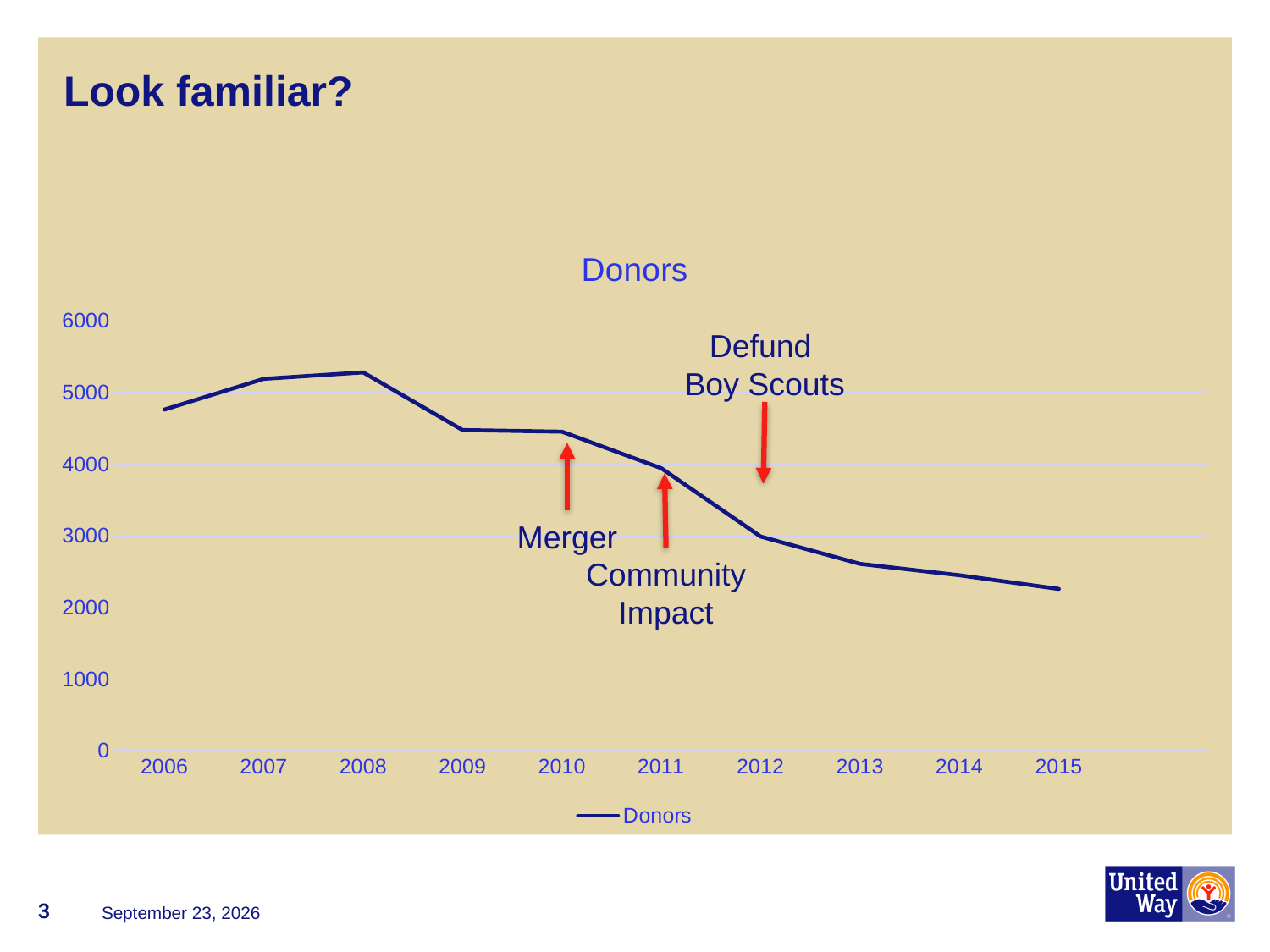
What is the title of the chart? Donors Do the donor values generally rise or fall from 2008 to 2015? fall Which year has the lowest number of donors? 2015 What kind of chart is shown on the slide? line chart How many years are plotted on the x axis? 10 Is the value for 2015 greater or less than 2000? greater Is the value for 2008 greater or less than 5000? greater Is the value for 2013 greater or less than 3000? less Which event is annotated with an arrow at 2010? Merger Which year has more donors, 2006 or 2015? 2006 How many series does the legend list? 1 Which year has the highest number of donors? 2008